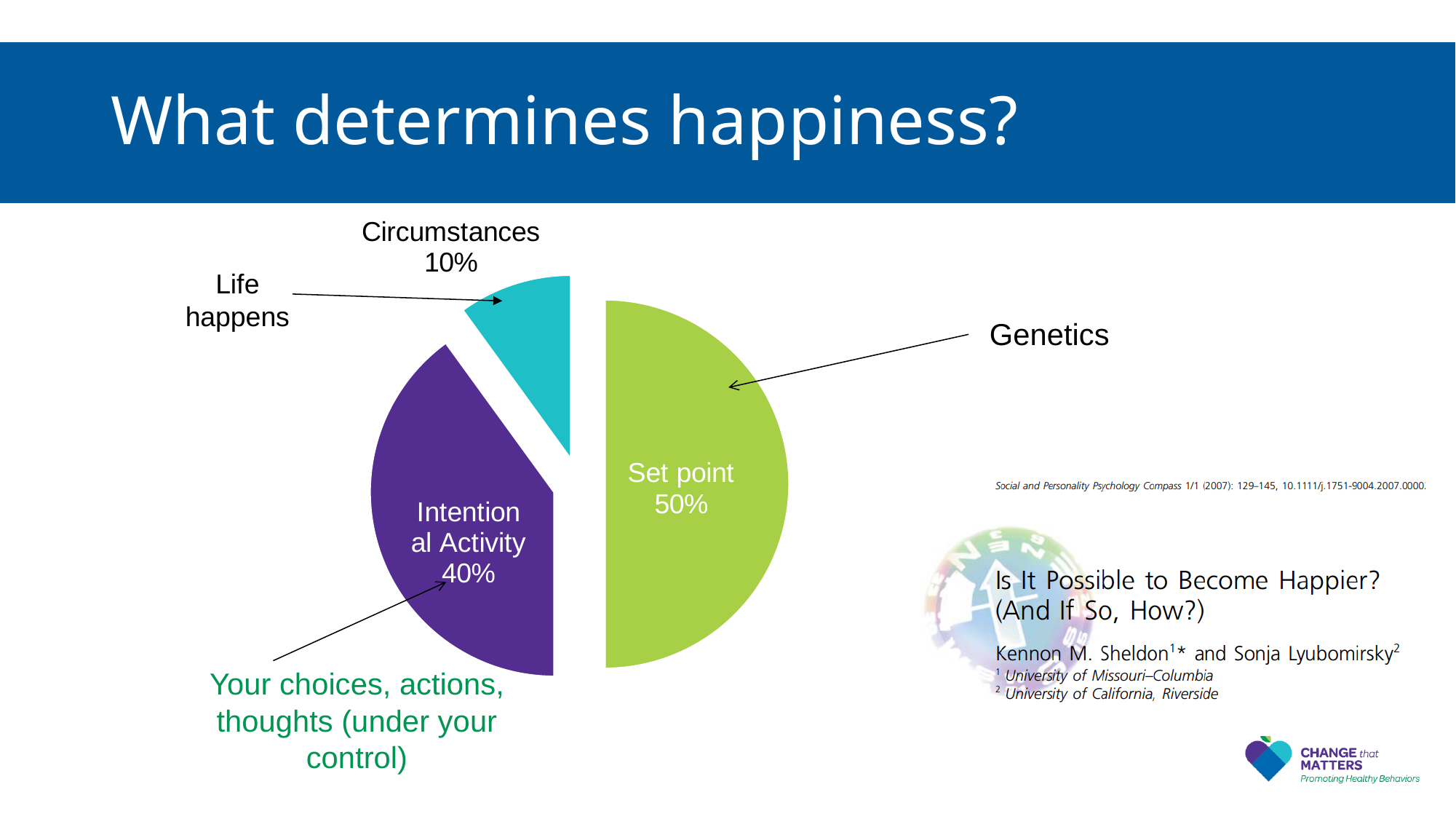
What is the difference in percentage points between the Intentional Activity slice and the Circumstances slice? 30 Which is larger, the Intentional Activity slice or the Circumstances slice? Intentional Activity Which slice of the pie chart is the largest? Set point What percentage of the pie is labelled Intentional Activity? 40% How many slices does the pie chart have? 3 What percentage of the pie is labelled Circumstances? 10% What colour is the Set point slice of the pie chart? Green What kind of chart is shown on the slide? Pie chart What percentage of the pie is labelled Set point? 50% Which slice of the pie chart is annotated with the label 'Genetics'? Set point What is the difference in percentage points between the Set point slice and the Intentional Activity slice? 10 Which slice of the pie chart is the smallest? Circumstances